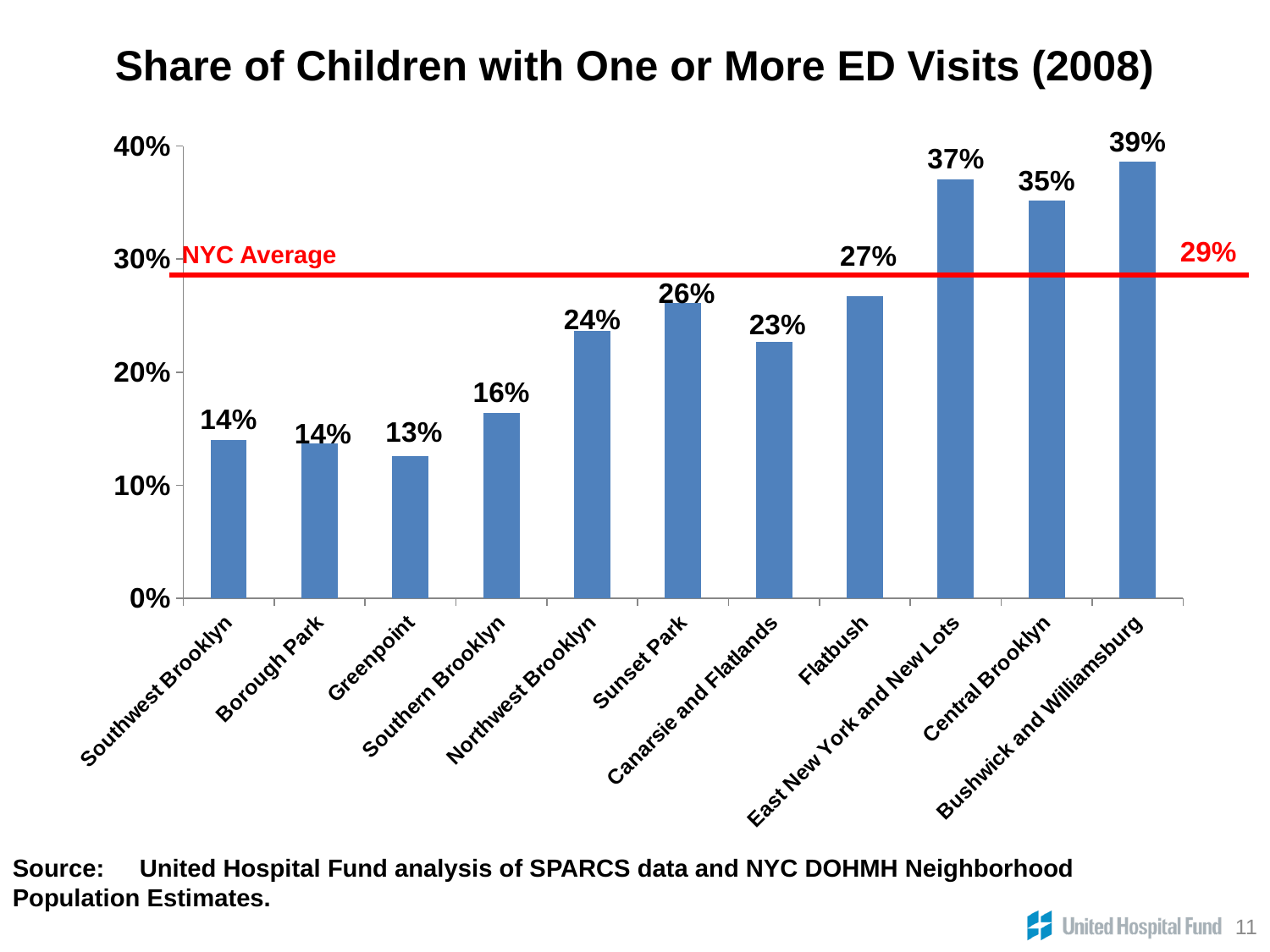
What is the value shown for Southern Brooklyn? 16% What is the share of children with one or more ED visits in Flatbush? 27% Is the value for Northwest Brooklyn greater or less than 20%? greater What is the difference between the values for East New York and New Lots and Sunset Park? 11% What is the title of the chart? Share of Children with One or More ED Visits (2008) How many neighborhoods are shown on the chart? 11 Which neighborhood has the highest share of children with one or more ED visits? Bushwick and Williamsburg What is the NYC Average value shown by the red line? 29% What kind of chart is shown on the slide? Bar chart Which neighborhood has the lowest share of children with one or more ED visits? Greenpoint Do the values generally rise or fall from left to right across the neighborhoods? Rise Which has a higher value, Central Brooklyn or Canarsie and Flatlands? Central Brooklyn